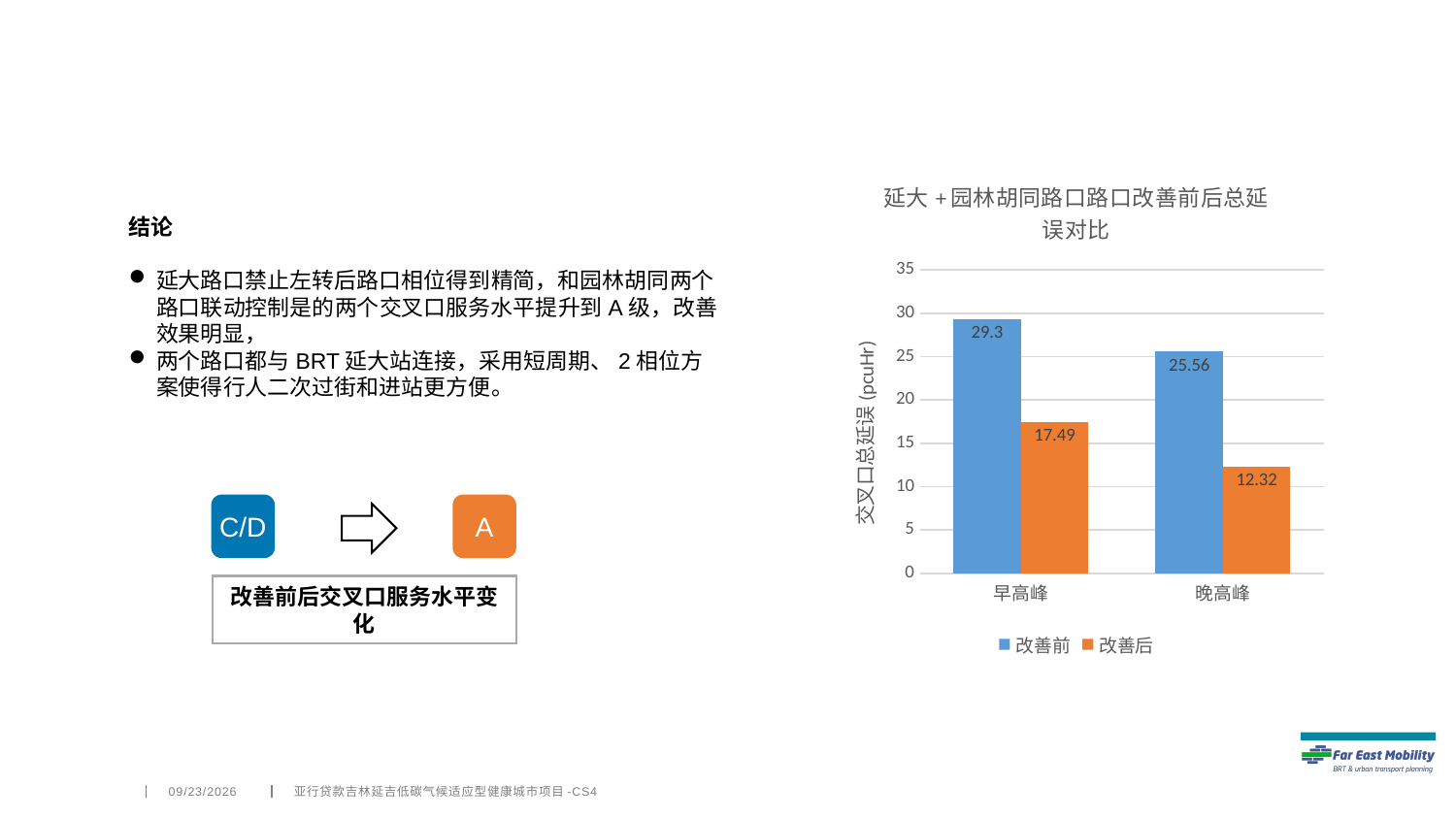
What type of chart is shown on the slide? Bar chart How many categories are shown on the x axis? 2 What is the difference between the 改善前 and 改善后 values for 早高峰? 11.81 Which is larger, the 改善后 value for 早高峰 or the 改善后 value for 晚高峰? 早高峰 What is the difference between the 改善前 and 改善后 values for 晚高峰? 13.24 Which bar in the chart has the highest value? 改善前 for 早高峰 Which bar in the chart has the lowest value? 改善后 for 晚高峰 What is the 改善后 value for 早高峰? 17.49 What is the 改善后 value for 晚高峰? 12.32 How many series does the legend list? 2 What is the 改善前 value for 早高峰? 29.3 What is the 改善前 value for 晚高峰? 25.56